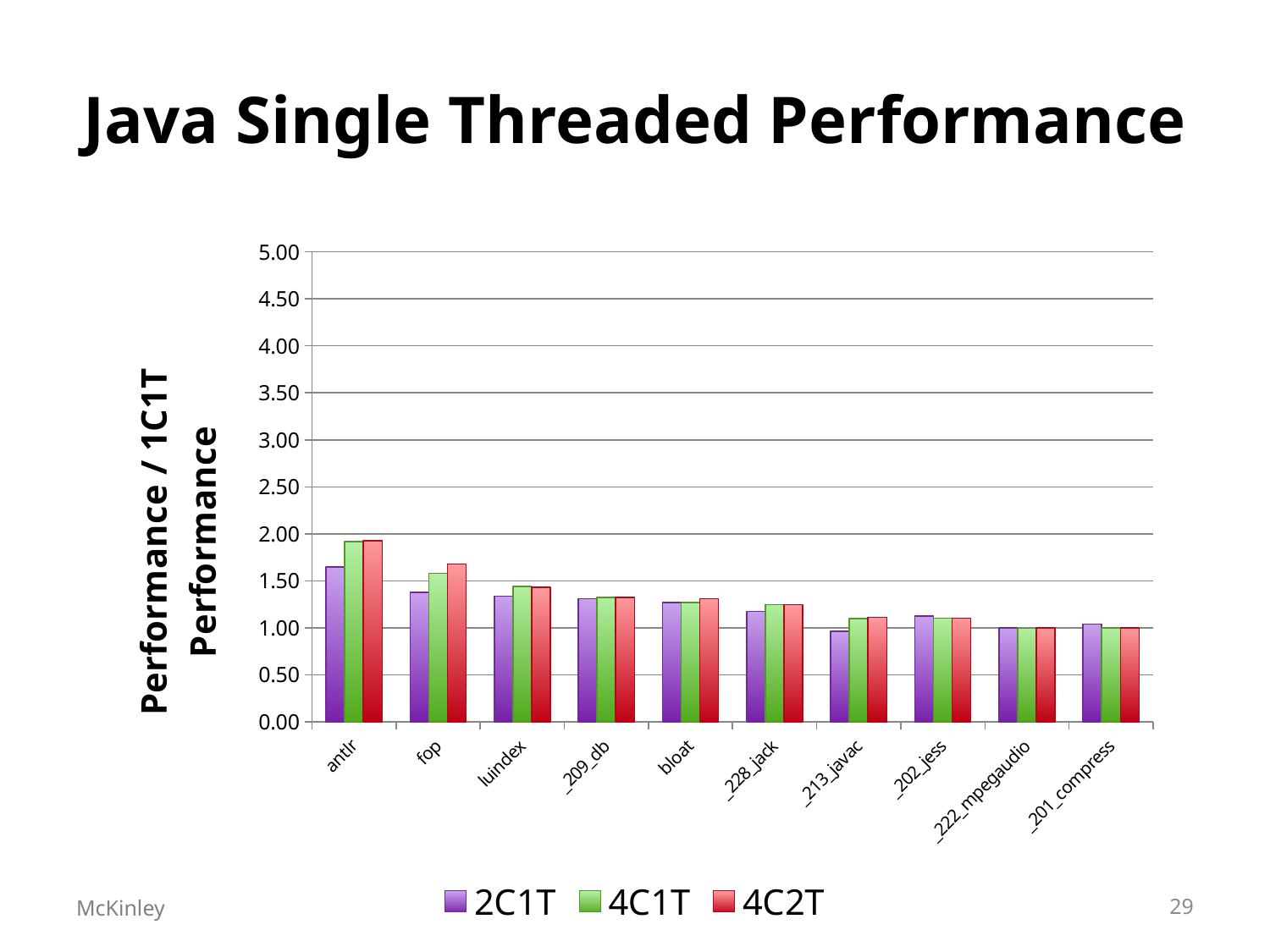
Which is larger, the 4C1T value for antlr or the 4C1T value for fop? antlr Is the 4C1T value for fop greater or less than 2.00? less Is the 2C1T value for fop greater or less than 1.50? less How many series does the legend list? 3 What kind of chart is shown on the slide? bar chart Which category has the highest 4C2T value? antlr Which is larger for fop, the 2C1T value or the 4C2T value? 4C2T Which category has the highest 4C1T value? antlr What is the title of the y axis? Performance / 1C1T Performance How many benchmark categories are shown on the x axis? 10 Is the 4C2T value for antlr greater or less than 1.50? greater